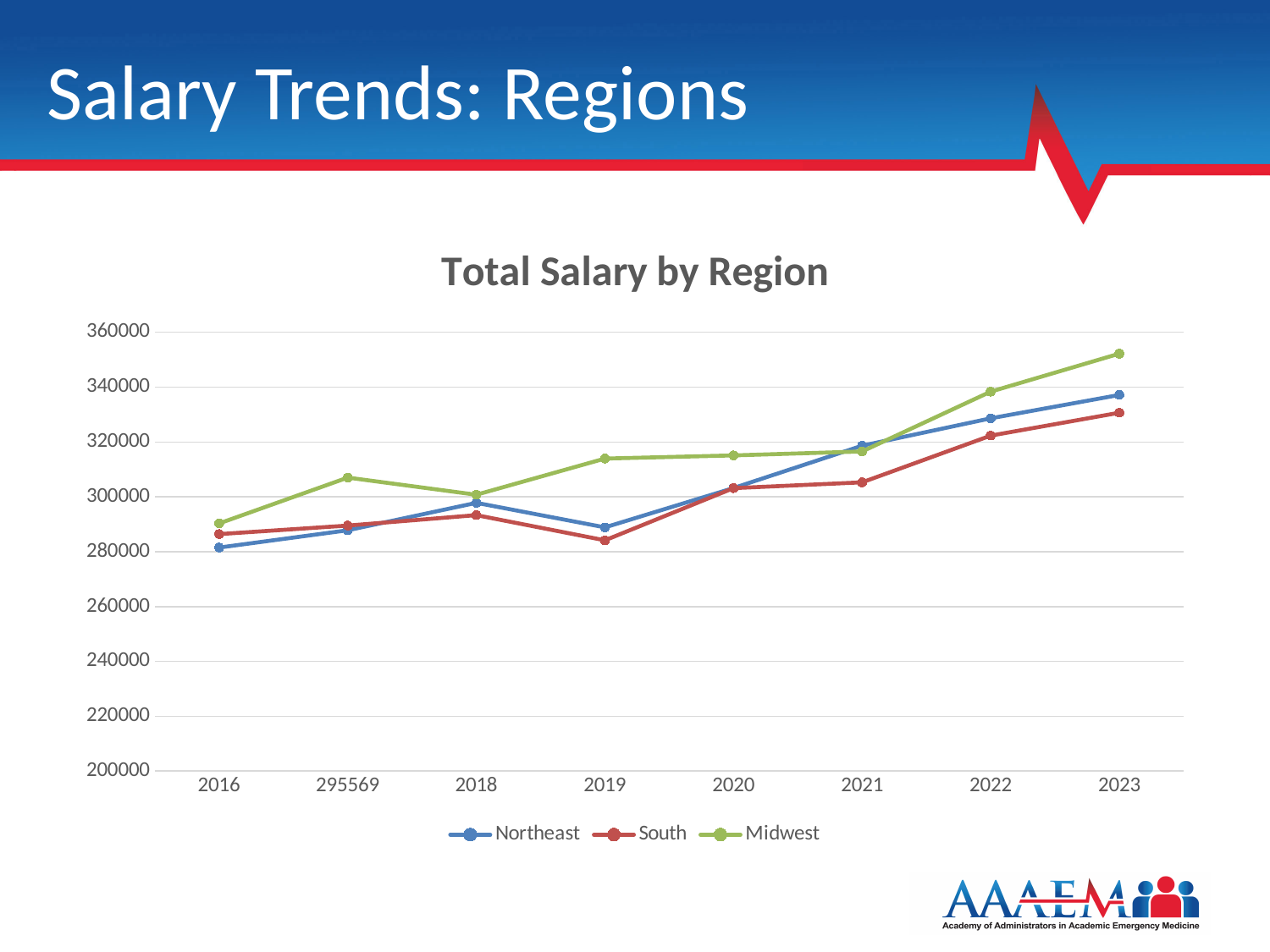
How many points are plotted along the x axis for each series? 8 Is the South value for 2019 greater or less than 300000? less What kind of chart is shown on the slide? Line chart Which region has the highest value in 2023? Midwest In which year does the Midwest line reach its highest value? 2023 Which is larger in 2019, the Midwest value or the Northeast value? Midwest Does the Midwest line rise or fall from 2021 to 2023? Rise Which region is represented by the green line? Midwest Is the Midwest value for 2023 greater or less than 340000? greater In which year is the Northeast value lowest? 2016 How many series does the legend list? 3 What is the title of the chart? Total Salary by Region